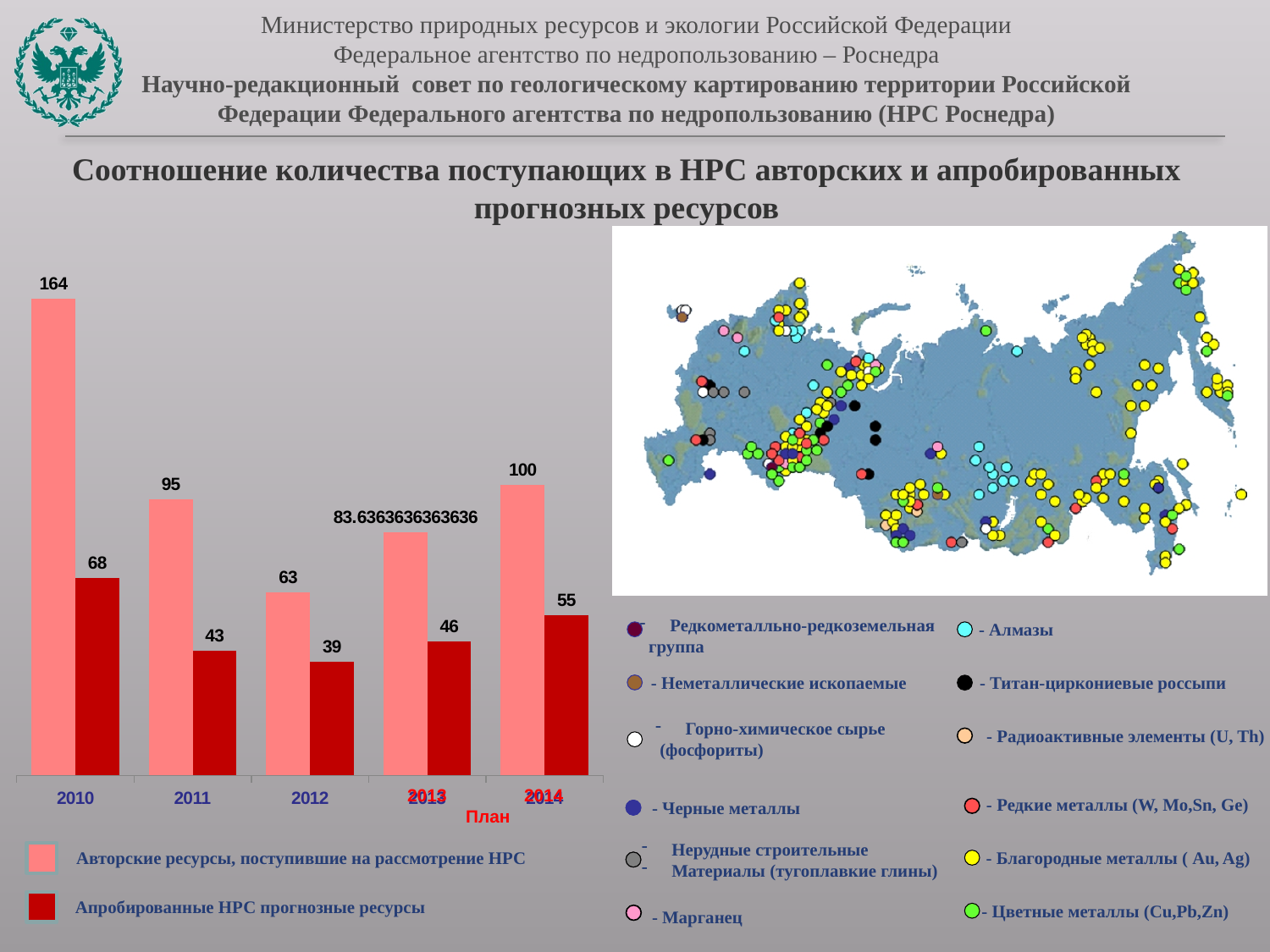
What is the difference between the pink bar values for 2014 and 2011? 5 How many series does the bar chart legend list? 2 What value is printed above the pink bar for 2013? 83.6363636363636 What is the value of the dark red series (Апробированные НРС прогнозные ресурсы) for 2012? 39 What kind of chart is shown on the left of the slide? bar chart Which colour represents Апробированные НРС прогнозные ресурсы in the bar chart? dark red How many years are shown on the x axis of the bar chart? 5 Which year has the highest value for Авторские ресурсы, поступившие на рассмотрение НРС? 2010 What is the value of the pink series (Авторские ресурсы, поступившие на рассмотрение НРС) for 2010? 164 What is the difference between the two series' values in 2010? 96 Which year has the lowest value for Апробированные НРС прогнозные ресурсы? 2012 Which is larger: the dark red bar for 2011 or the dark red bar for 2014? 2014